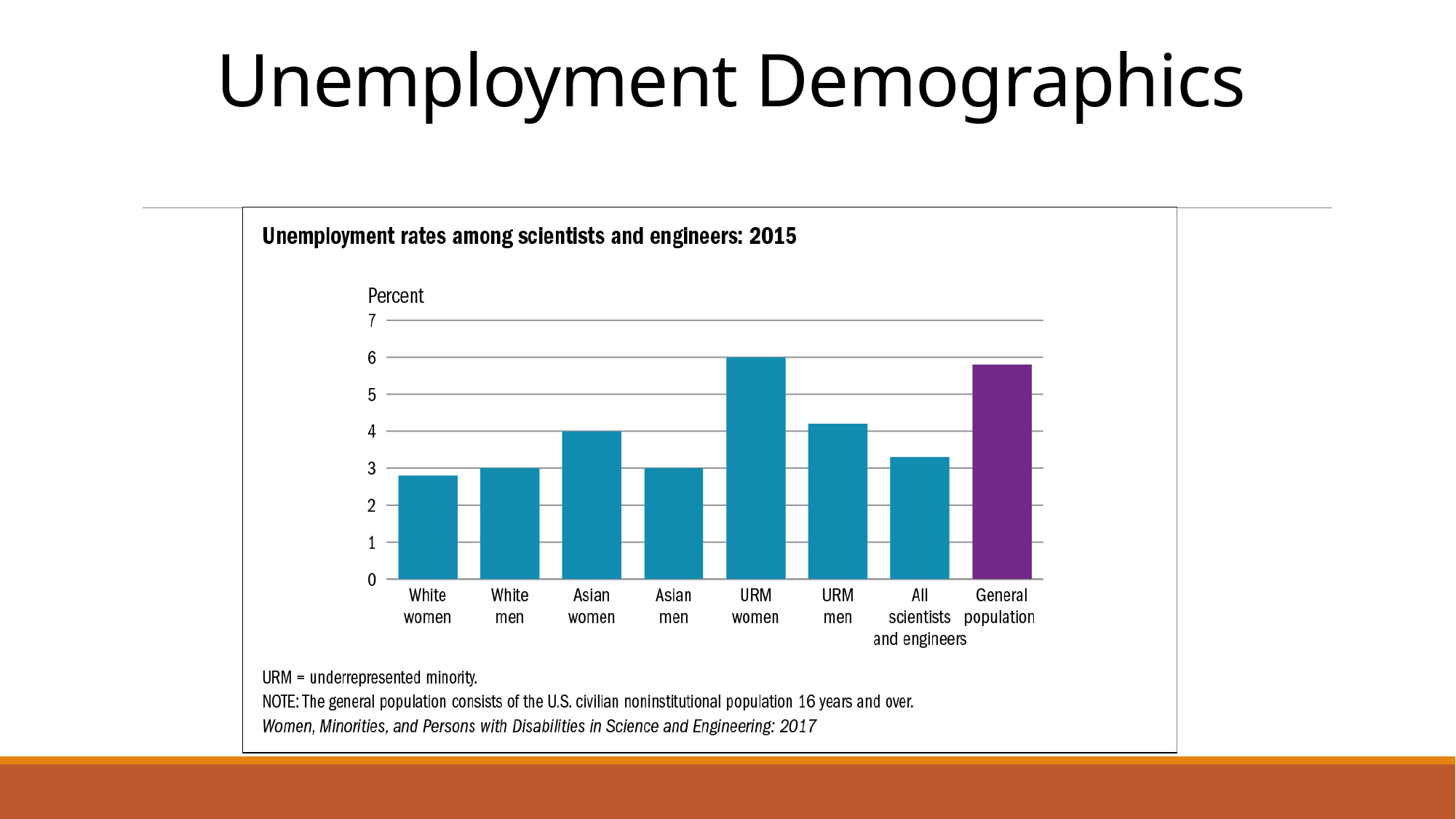
Which is larger, the unemployment rate for URM women or for Asian women? URM women How many categories are shown on the x axis of the chart? 8 What is the title of the chart? Unemployment rates among scientists and engineers: 2015 What is the unemployment rate (percent) for URM women? 6 What is the unemployment rate (percent) for Asian women? 4 What is the unemployment rate (percent) for Asian men? 3 Is the value for General population greater or less than 5? greater What type of chart is shown on the slide? bar chart Is the value for All scientists and engineers greater or less than 3? greater Which category has the highest unemployment rate? URM women What is the difference between the unemployment rates for URM women and Asian men? 3 What is the unemployment rate (percent) for White men? 3